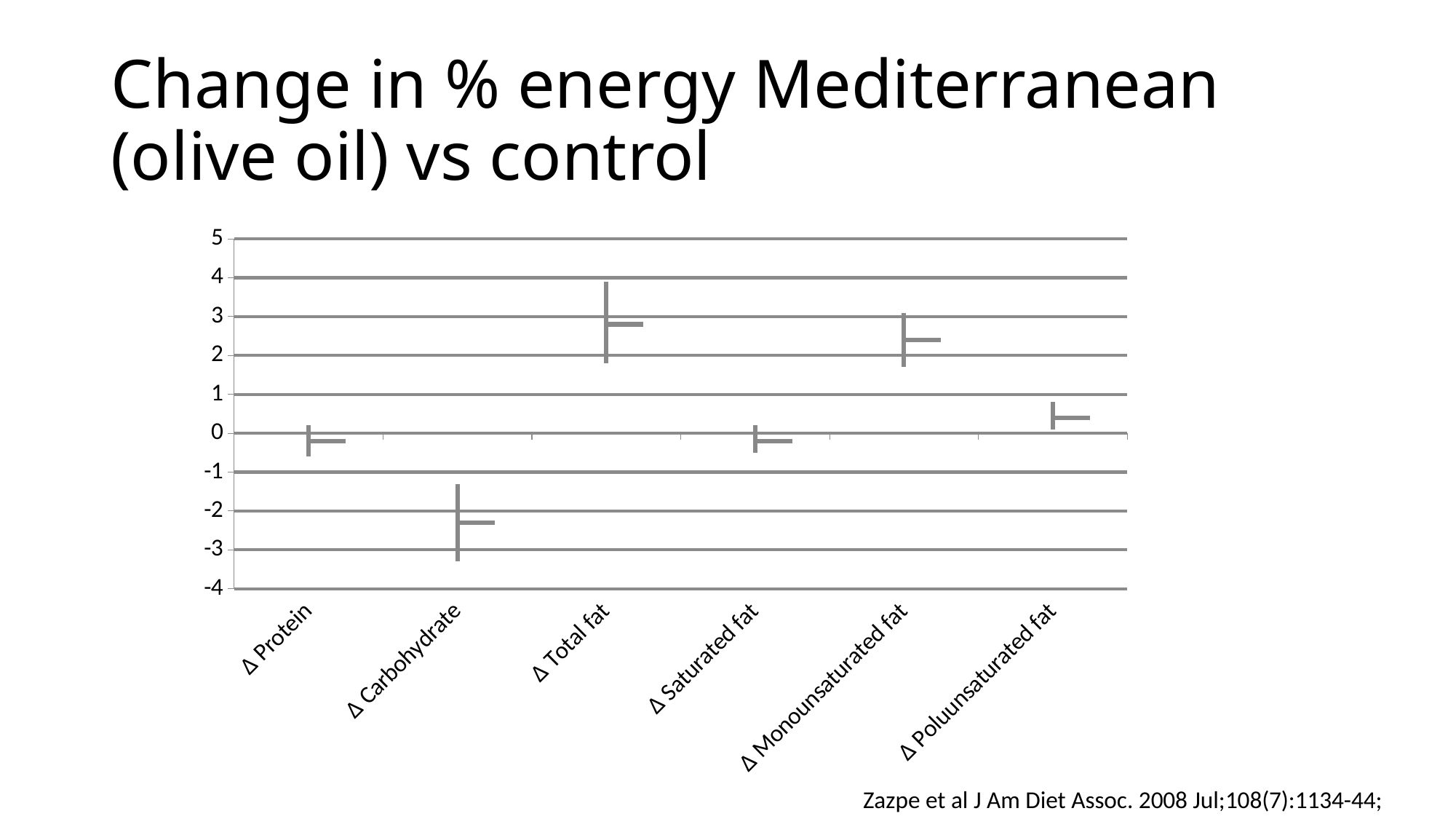
Which is larger, the value for Δ Total fat or the value for Δ Monounsaturated fat? Δ Total fat Which is larger, the value for Δ Carbohydrate or the value for Δ Poluunsaturated fat? Δ Poluunsaturated fat Is the value for Δ Carbohydrate greater or less than 0? less Which category has the lowest value on the chart? Δ Carbohydrate Which category has the highest value on the chart? Δ Total fat Is the value for Δ Poluunsaturated fat greater or less than 0? greater What is the title of the slide containing the chart? Change in % energy Mediterranean (olive oil) vs control Is the value for Δ Poluunsaturated fat greater or less than 1? less How many categories are shown on the x axis of the chart? 6